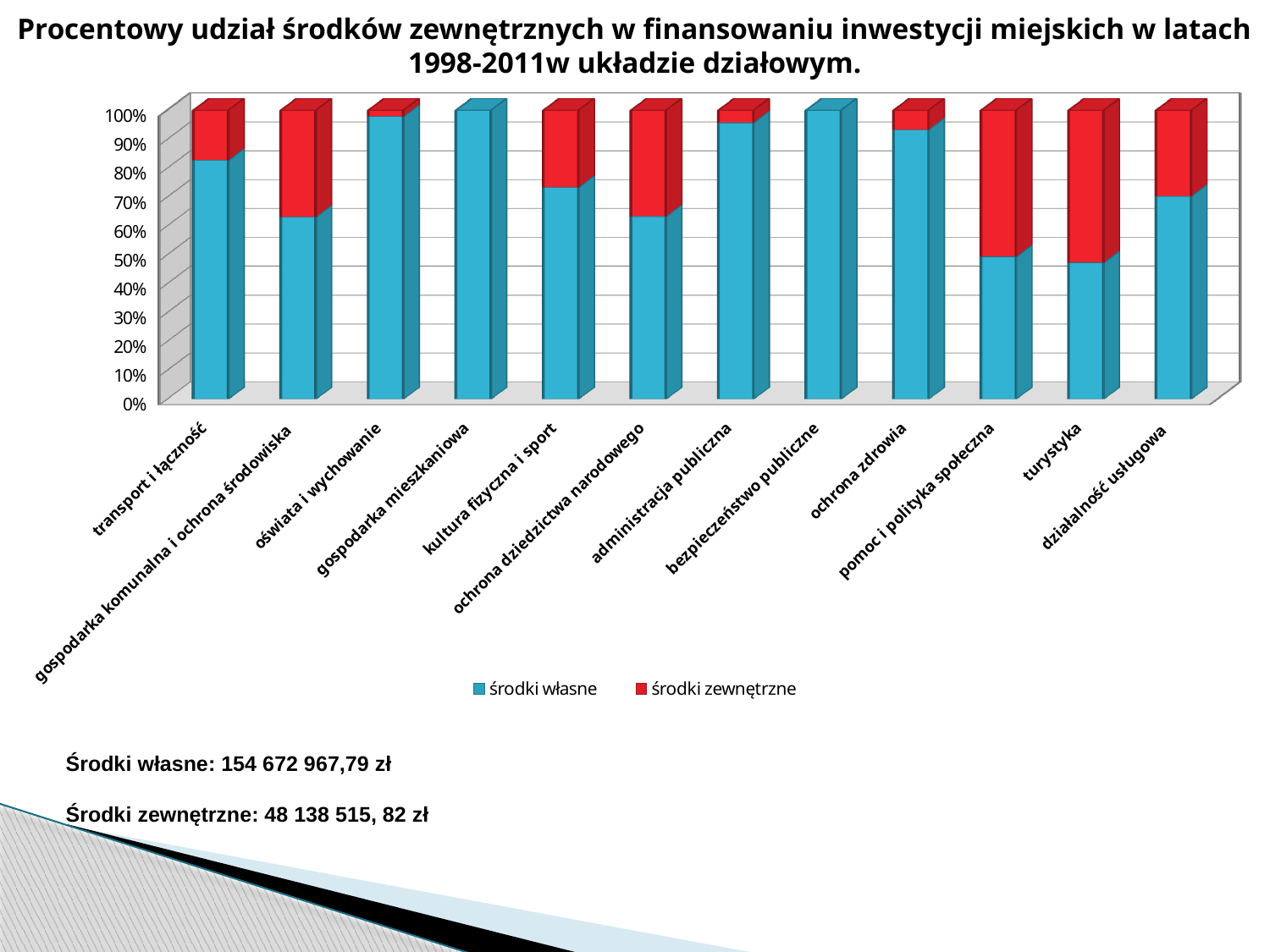
Which has a larger share of środki własne: działalność usługowa or turystyka? działalność usługowa Is the share of środki własne for gospodarka komunalna i ochrona środowiska greater or less than 70%? less What are the two series named in the chart legend? środki własne, środki zewnętrzne Which colour represents środki zewnętrzne in the chart? Red Is the share of środki własne for kultura fizyczna i sport greater or less than 70%? greater What kind of chart is shown on the slide? Stacked bar chart How many series does the chart legend list? 2 Which has a larger share of środki zewnętrzne: ochrona dziedzictwa narodowego or kultura fizyczna i sport? ochrona dziedzictwa narodowego Which has a larger share of środki własne: transport i łączność or gospodarka komunalna i ochrona środowiska? transport i łączność Is the share of środki własne for działalność usługowa greater or less than 60%? greater How many categories (działy) are shown on the x axis of the chart? 12